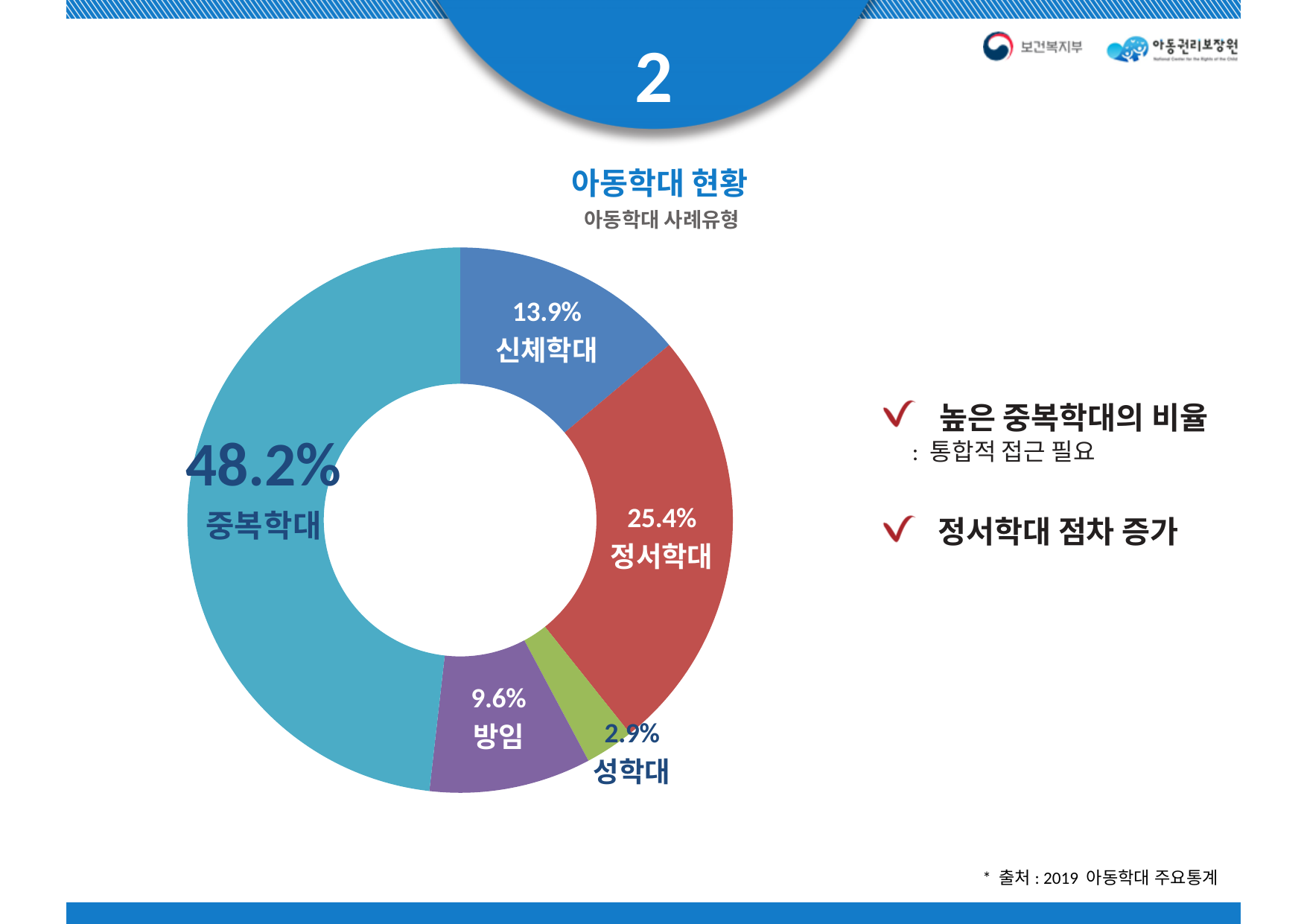
Which category has the largest share of the chart? 중복학대 What is the value shown for 정서학대? 25.4% Which category has the smallest share of the chart? 성학대 What is the value shown for 방임? 9.6% What is the title of the chart? 아동학대 사례유형 What kind of chart is shown on the slide? Pie chart (donut) Which is larger, the share for 방임 or the share for 성학대? 방임 How many categories are shown in the chart? 5 What is the difference between the shares of 정서학대 and 신체학대? 11.5% What colour is the slice for 정서학대? Red What share of the pie does 중복학대 account for? 48.2% What is the value shown for 신체학대? 13.9%